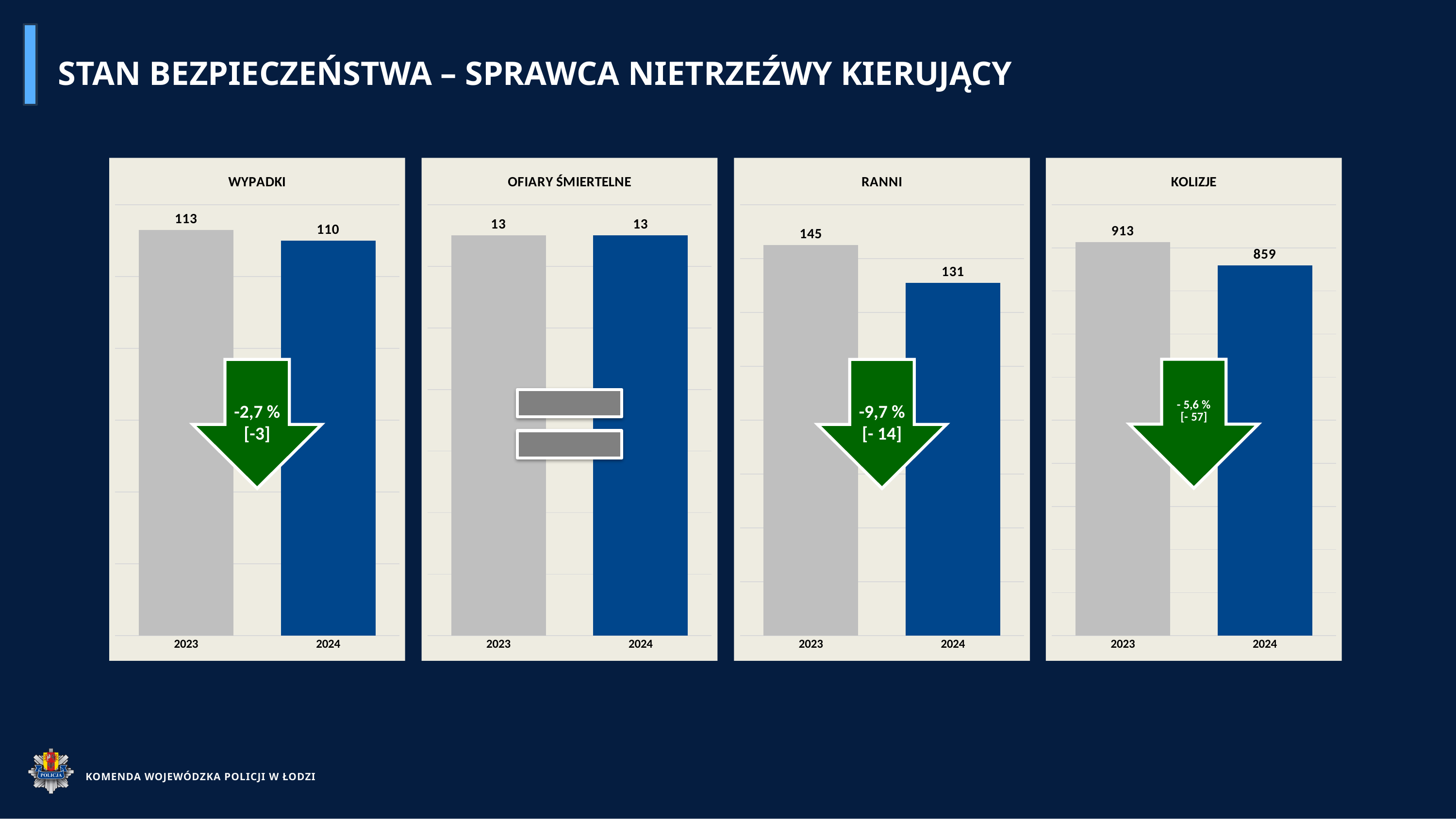
In the RANNI chart, what is the difference between the 2023 and 2024 values? 14 What kind of chart is the OFIARY ŚMIERTELNE chart? bar chart In the RANNI chart, which year has the lowest value? 2024 How many bars are plotted in the WYPADKI chart? 2 In the KOLIZJE chart, which year has the higher value, 2023 or 2024? 2023 In the KOLIZJE chart, what is the difference between the 2023 and 2024 values? 54 In the WYPADKI chart, what is the value for 2024? 110 In the OFIARY ŚMIERTELNE chart, what is the value for 2024? 13 In the RANNI chart, what is the value for 2023? 145 In the KOLIZJE chart, what is the value for 2024? 859 In the WYPADKI chart, do the values rise or fall from 2023 to 2024? fall In the WYPADKI chart, what is the value for 2023? 113